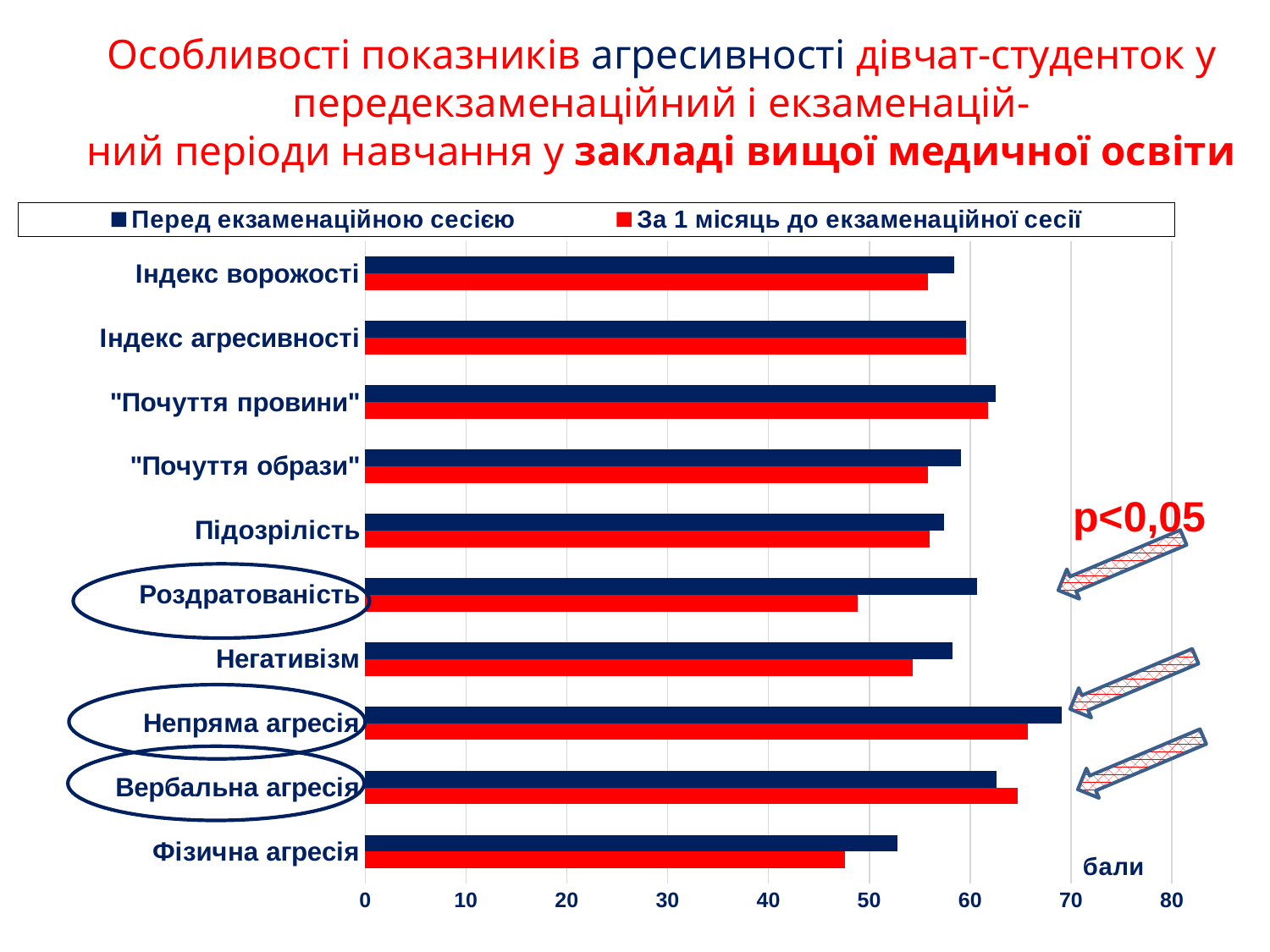
Is the value for "Роздратованість" in the series "За 1 місяць до екзаменаційної сесії" greater or less than 60? less For "Роздратованість", which series has the larger value: "Перед екзаменаційною сесією" or "За 1 місяць до екзаменаційної сесії"? Перед екзаменаційною сесією How many categories are plotted on the chart? 10 Which colour represents the series "За 1 місяць до екзаменаційної сесії" in the legend? red What unit label is shown next to the horizontal axis of the chart? бали What kind of chart is shown on the slide? bar chart Which category has the lowest value for the series "Перед екзаменаційною сесією"? Фізична агресія How many series does the legend list? 2 Is the value for "Фізична агресія" in the series "За 1 місяць до екзаменаційної сесії" greater or less than 50? less Is the value for "Непряма агресія" in the series "Перед екзаменаційною сесією" greater or less than 60? greater Which category has the highest value for the series "Перед екзаменаційною сесією"? Непряма агресія For "Фізична агресія", which series has the larger value: "Перед екзаменаційною сесією" or "За 1 місяць до екзаменаційної сесії"? Перед екзаменаційною сесією